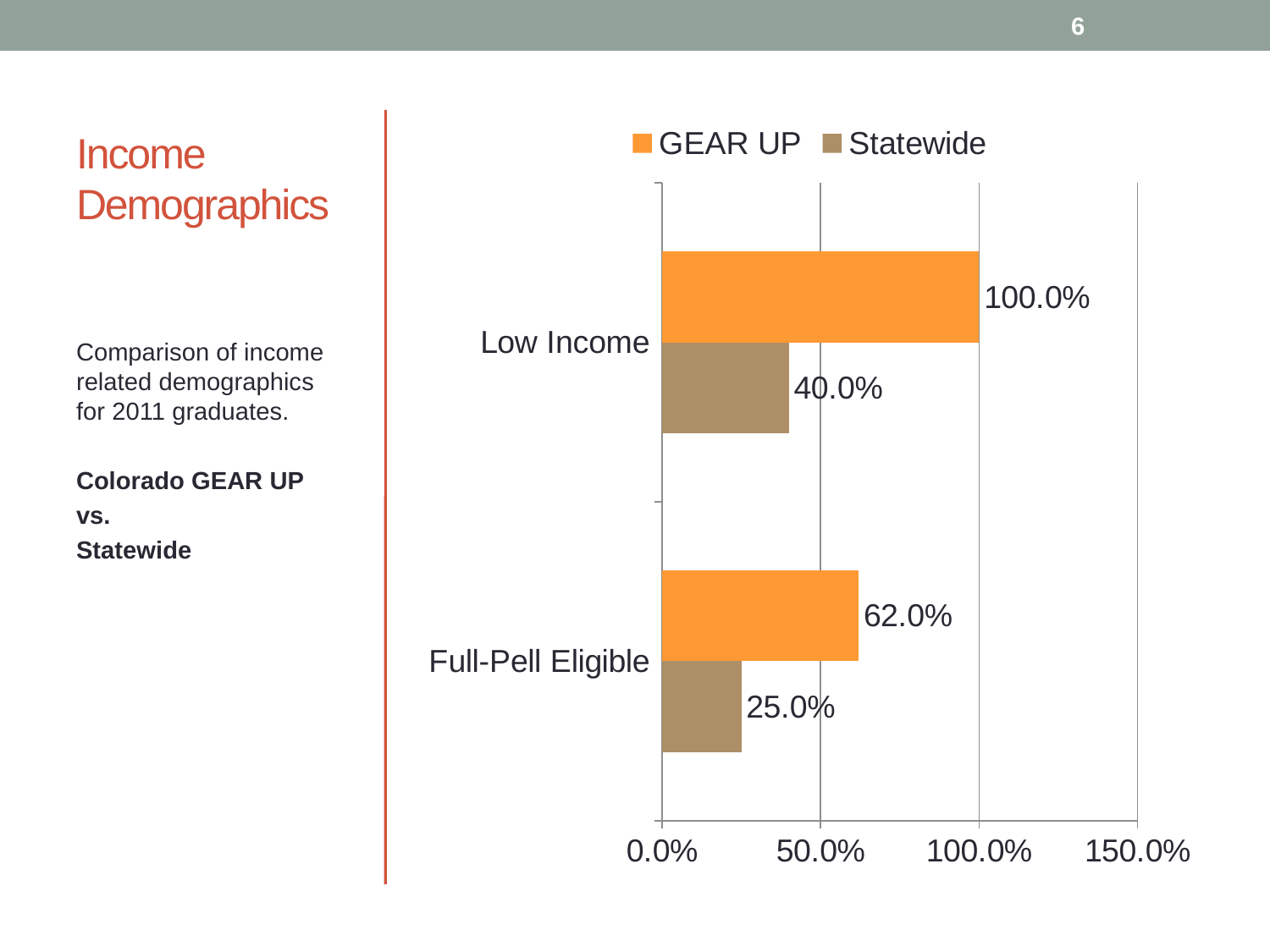
What is the GEAR UP value for Low Income? 100.0% Which is larger for Full-Pell Eligible, the GEAR UP value or the Statewide value? GEAR UP How many categories are shown on the chart? 2 How many series does the legend list? 2 What is the difference between the GEAR UP and Statewide values for Full-Pell Eligible? 37.0% What is the Statewide value for Full-Pell Eligible? 25.0% Which category has the lowest Statewide value? Full-Pell Eligible What is the Statewide value for Low Income? 40.0% Which category has the highest GEAR UP value? Low Income What kind of chart is shown on the slide? Bar chart What is the GEAR UP value for Full-Pell Eligible? 62.0% What is the difference between the GEAR UP and Statewide values for Low Income? 60.0%